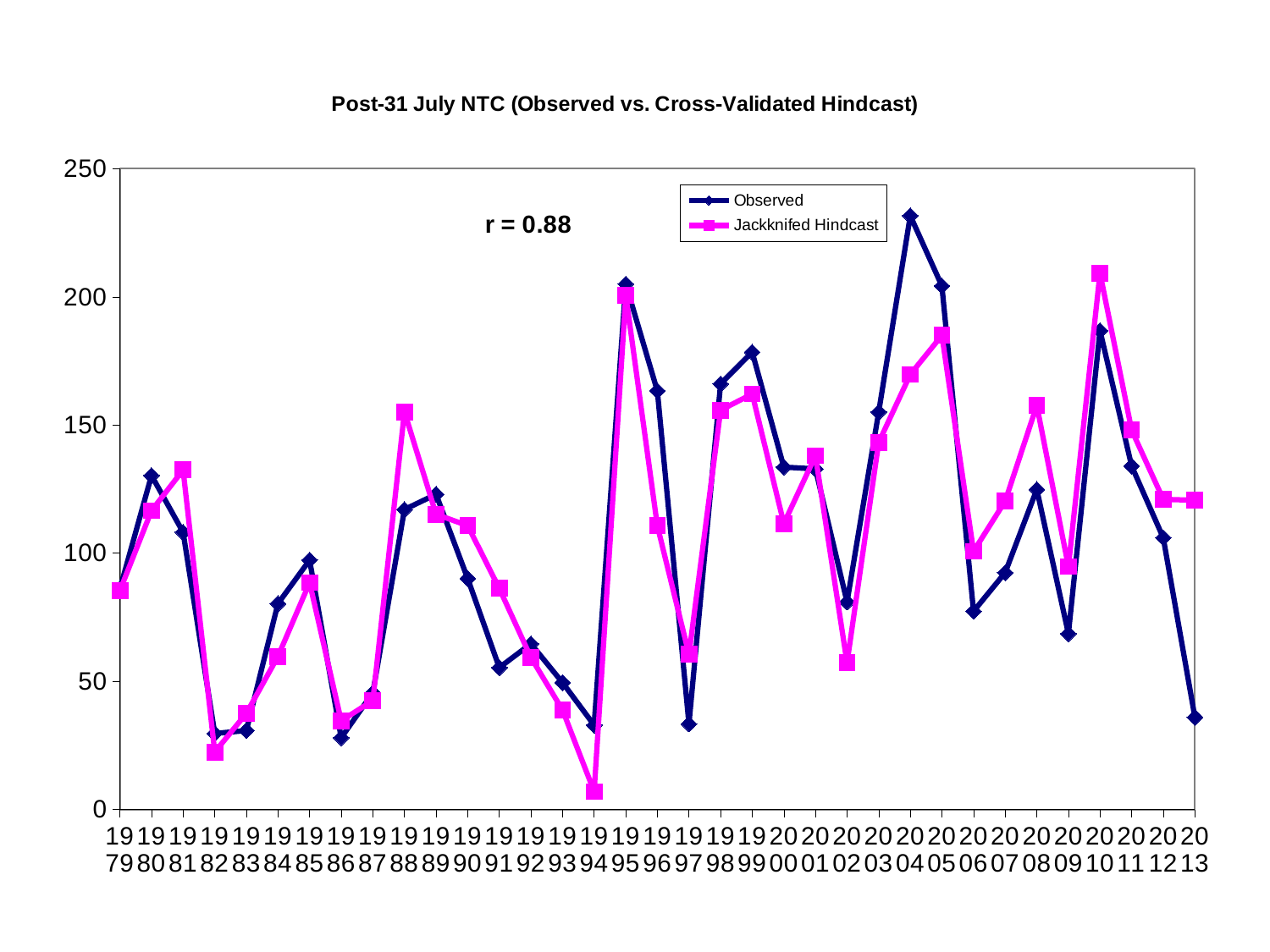
Is the Observed value for 2004 greater or less than 200? greater In 1988, which series has the larger value, Observed or Jackknifed Hindcast? Jackknifed Hindcast In 2004, which series has the larger value, Observed or Jackknifed Hindcast? Observed In which year does the Observed series reach its highest value? 2004 What correlation value is printed on the chart? r = 0.88 Is the Jackknifed Hindcast value for 1994 greater or less than 50? less What kind of chart is shown on the slide? Line chart What are the two series named in the legend? Observed and Jackknifed Hindcast How many series does the legend list? 2 How many years are plotted along the x axis? 35 In which year does the Jackknifed Hindcast series reach its lowest value? 1994 Is the Observed value for 2013 greater or less than 50? less